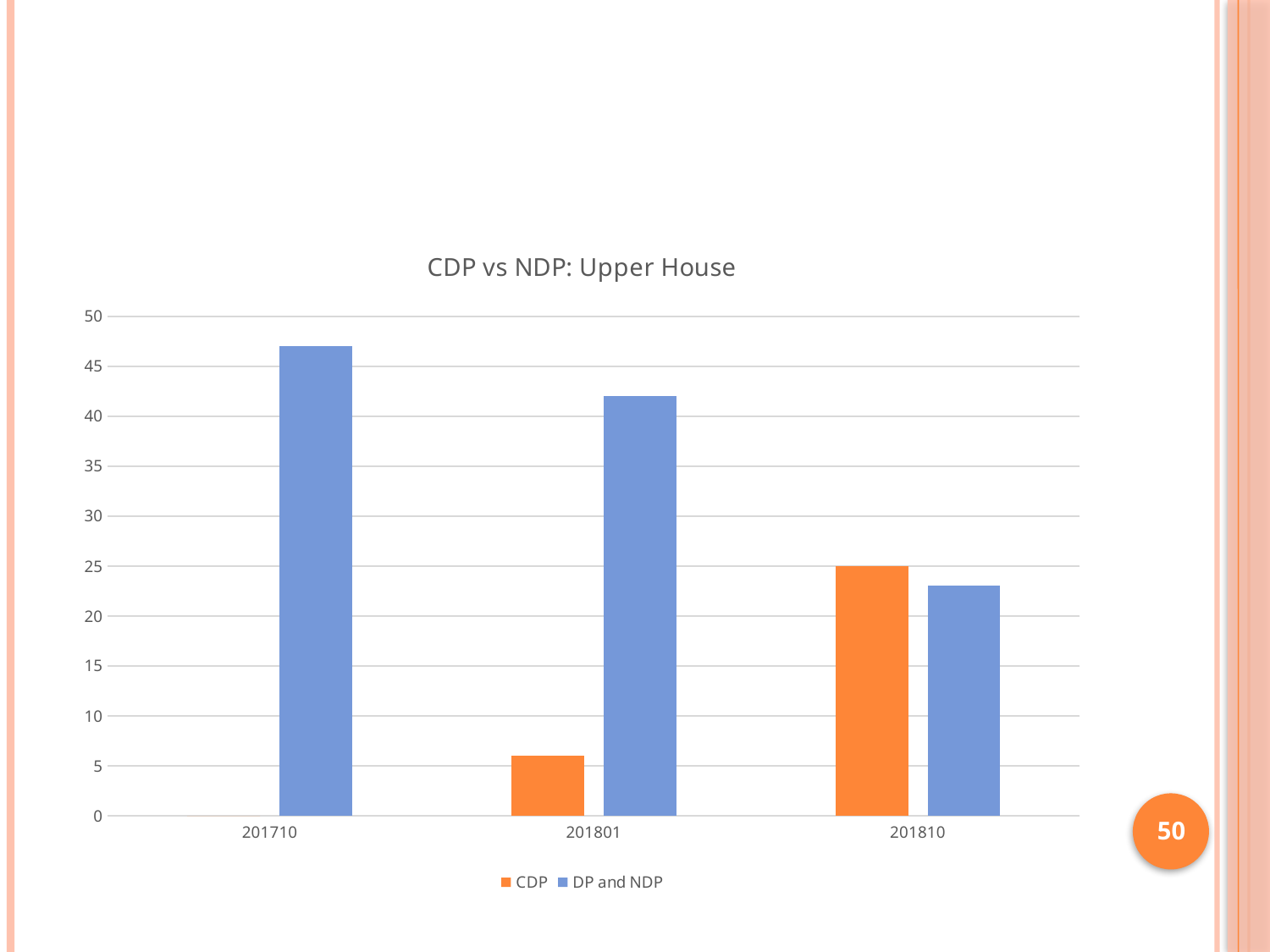
What is the title of the chart? CDP vs NDP: Upper House Which category has the lowest value for CDP? 201710 How many series does the legend list? 2 Which category has the highest value for DP and NDP? 201710 At 201801, which series has the larger value, CDP or DP and NDP? DP and NDP What is the value for CDP at 201810? 25 Is the value for DP and NDP at 201801 greater or less than 40? greater Do the values for DP and NDP rise or fall from 201710 to 201810? fall What type of chart is shown on the slide? bar chart Is the value for DP and NDP at 201710 greater or less than 45? greater Is the value for CDP at 201801 greater or less than 10? less How many categories are shown on the x axis? 3